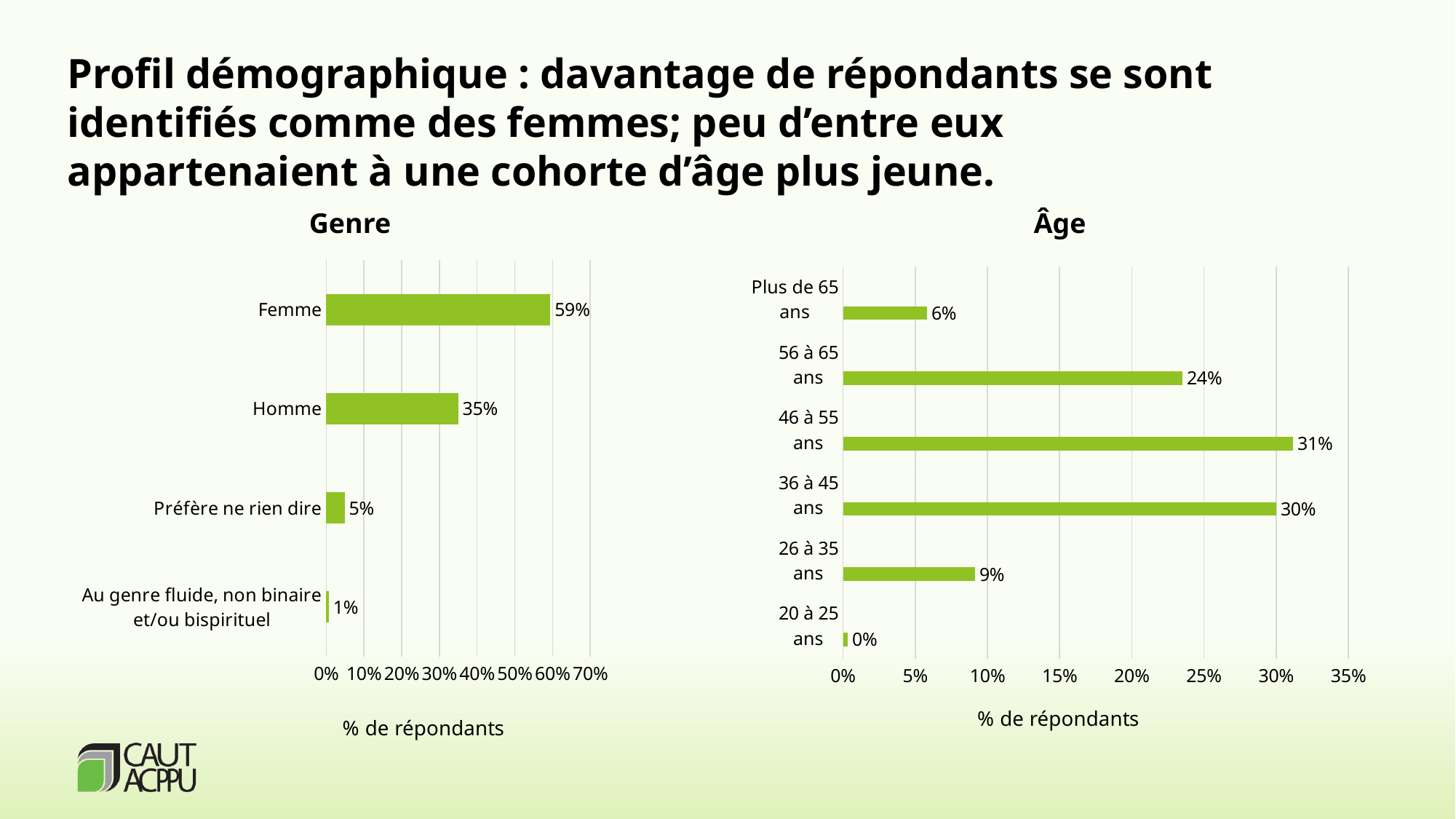
In the Âge chart, how many age groups are shown? 6 What type of chart is the Âge chart? Bar chart In the Âge chart, which age group has the highest value? 46 à 55 ans In the Âge chart, what is the difference between the values for 56 à 65 ans and 26 à 35 ans? 15% In the Genre chart, how many categories are shown? 4 In the Âge chart, which is larger, the value for 56 à 65 ans or the value for Plus de 65 ans? 56 à 65 ans In the Genre chart, what percentage of respondents identified as Femme? 59% In the Genre chart, which category has the lowest value? Au genre fluide, non binaire et/ou bispirituel In the Genre chart, what is the difference between the Femme and Homme values? 24% In the Âge chart, what is the value for 46 à 55 ans? 31% In the Âge chart, what is the value for 26 à 35 ans? 9% In the Genre chart, what is the value for Homme? 35%